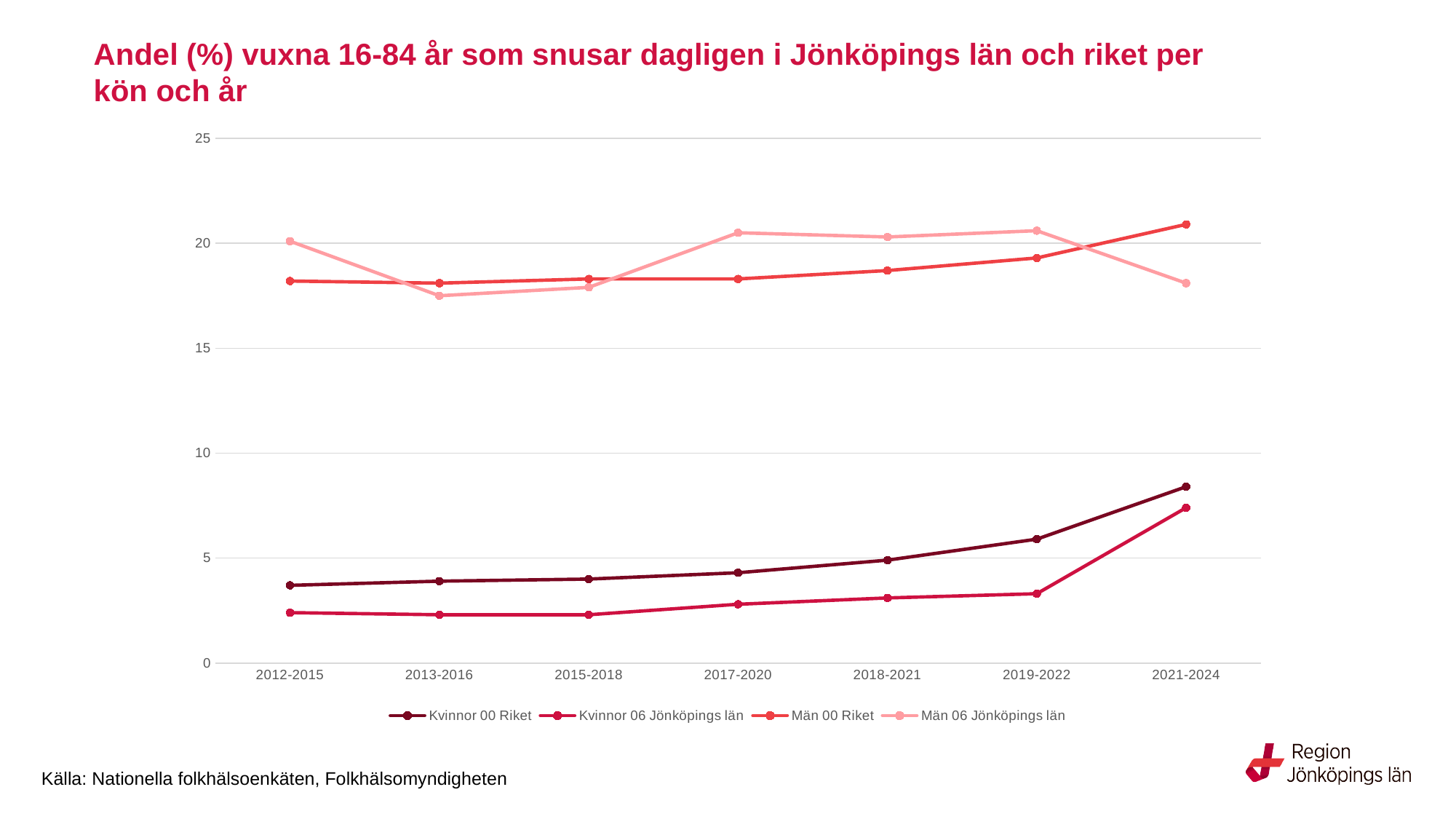
How many series does the legend list? 4 In 2012-2015, which is larger: Män 00 Riket or Män 06 Jönköpings län? Män 06 Jönköpings län Is the value for Kvinnor 00 Riket in 2019-2022 greater or less than 5? greater What kind of chart is shown on the slide? line chart In 2021-2024, which is larger: Män 00 Riket or Män 06 Jönköpings län? Män 00 Riket How many time periods are shown on the x axis? 7 What source is cited below the chart? Nationella folkhälsoenkäten, Folkhälsomyndigheten Which series has the lowest value in 2012-2015? Kvinnor 06 Jönköpings län Is the value for Kvinnor 06 Jönköpings län in 2012-2015 greater or less than 5? less Is the value for Män 00 Riket in 2021-2024 greater or less than 20? greater In which period does Kvinnor 06 Jönköpings län reach its highest value? 2021-2024 Does the value for Kvinnor 00 Riket rise or fall from 2012-2015 to 2021-2024? rise